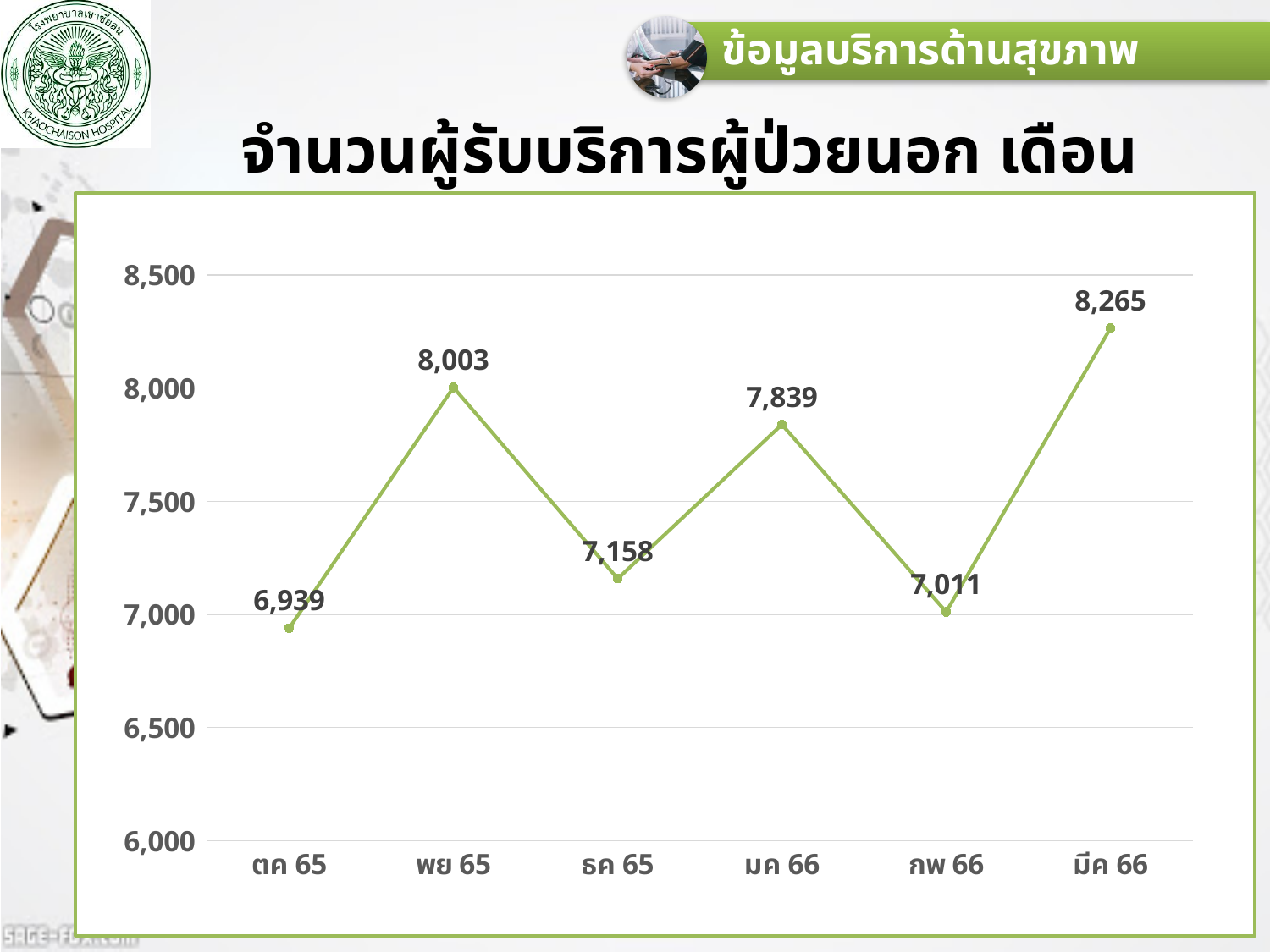
What is the difference between the values for มีค 66 and กพ 66? 1,254 What is the value for ตค 65? 6,939 Which is larger, the value for พย 65 or the value for มค 66? พย 65 What is the value for กพ 66? 7,011 Which month has the highest value? มีค 66 How many months are plotted on the chart? 6 What kind of chart is shown on the slide? line chart What is the difference between the values for พย 65 and ธค 65? 845 Which month has the lowest value? ตค 65 What is the value for มค 66? 7,839 Does the value rise or fall from กพ 66 to มีค 66? rise Is the value for ธค 65 greater or less than 7,500? less